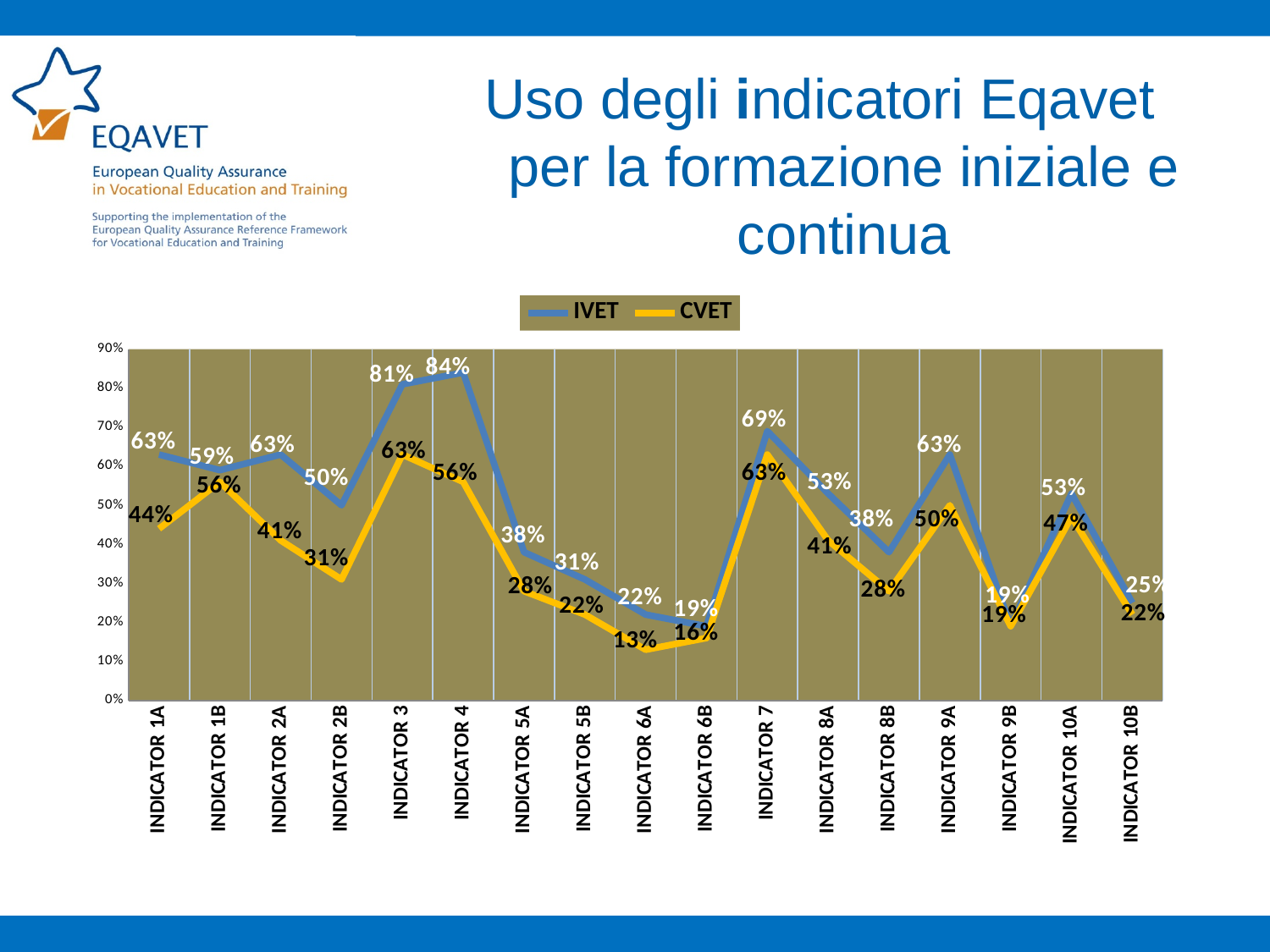
What kind of chart is shown on the slide? Line chart What is the IVET value for INDICATOR 3? 81% Does the IVET line rise or fall from INDICATOR 4 to INDICATOR 6B? Falls For INDICATOR 7, which series has the larger value, IVET or CVET? IVET What is the CVET value for INDICATOR 6A? 13% How many series does the legend list? 2 What is the CVET value for INDICATOR 9A? 50% What are the two series named in the legend? IVET and CVET For which indicator is the CVET value lowest? INDICATOR 6A How many indicators are shown along the x axis? 17 For which indicator is the IVET value highest? INDICATOR 4 What is the difference between the IVET and CVET values for INDICATOR 1A? 19 percentage points